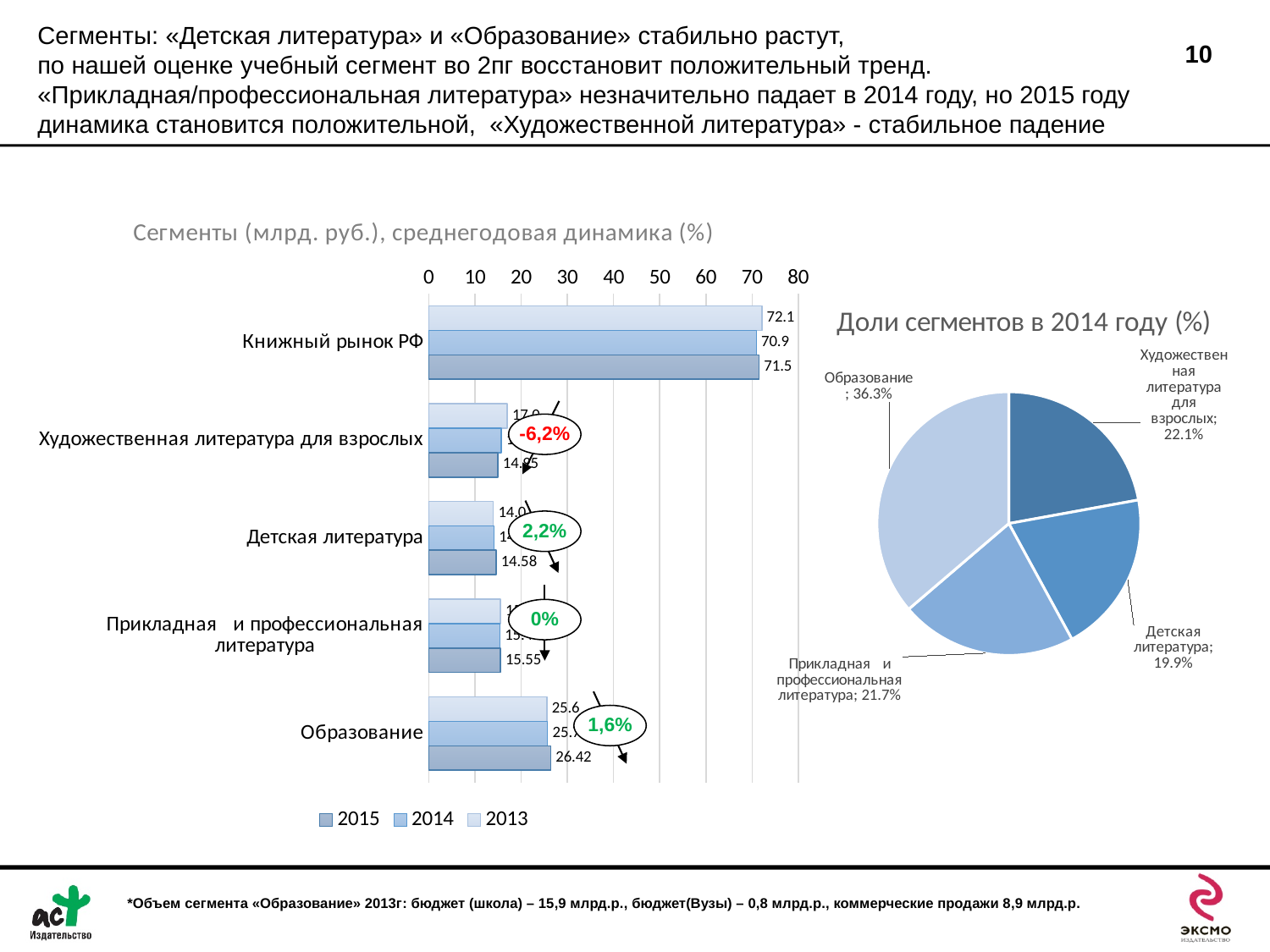
In the bar chart «Сегменты (млрд. руб.), среднегодовая динамика (%)», what average annual change is annotated for «Художественная литература для взрослых»? -6,2% In the pie chart «Доли сегментов в 2014 году (%)», how many percentage points larger is the share of «Образование» than the share of «Детская литература»? 16.4 In the pie chart «Доли сегментов в 2014 году (%)», which segment has the smallest share? Детская литература How many slices does the pie chart «Доли сегментов в 2014 году (%)» have? 4 In the pie chart «Доли сегментов в 2014 году (%)», which segment has the largest share? Образование In the bar chart «Сегменты (млрд. руб.), среднегодовая динамика (%)», is the 2014 value for «Детская литература» greater or less than 20? less What kind of chart is the chart titled «Сегменты (млрд. руб.), среднегодовая динамика (%)»? Bar chart In the pie chart «Доли сегментов в 2014 году (%)», what share does «Образование» have? 36.3% In the bar chart «Сегменты (млрд. руб.), среднегодовая динамика (%)», how many series does the legend list? 3 In the bar chart «Сегменты (млрд. руб.), среднегодовая динамика (%)», what is the 2015 value for «Книжный рынок РФ»? 71.5 In the bar chart «Сегменты (млрд. руб.), среднегодовая динамика (%)», what is the 2015 value for «Образование»? 26.42 In the bar chart «Сегменты (млрд. руб.), среднегодовая динамика (%)», which is larger for «Книжный рынок РФ»: the 2013 value or the 2014 value? 2013